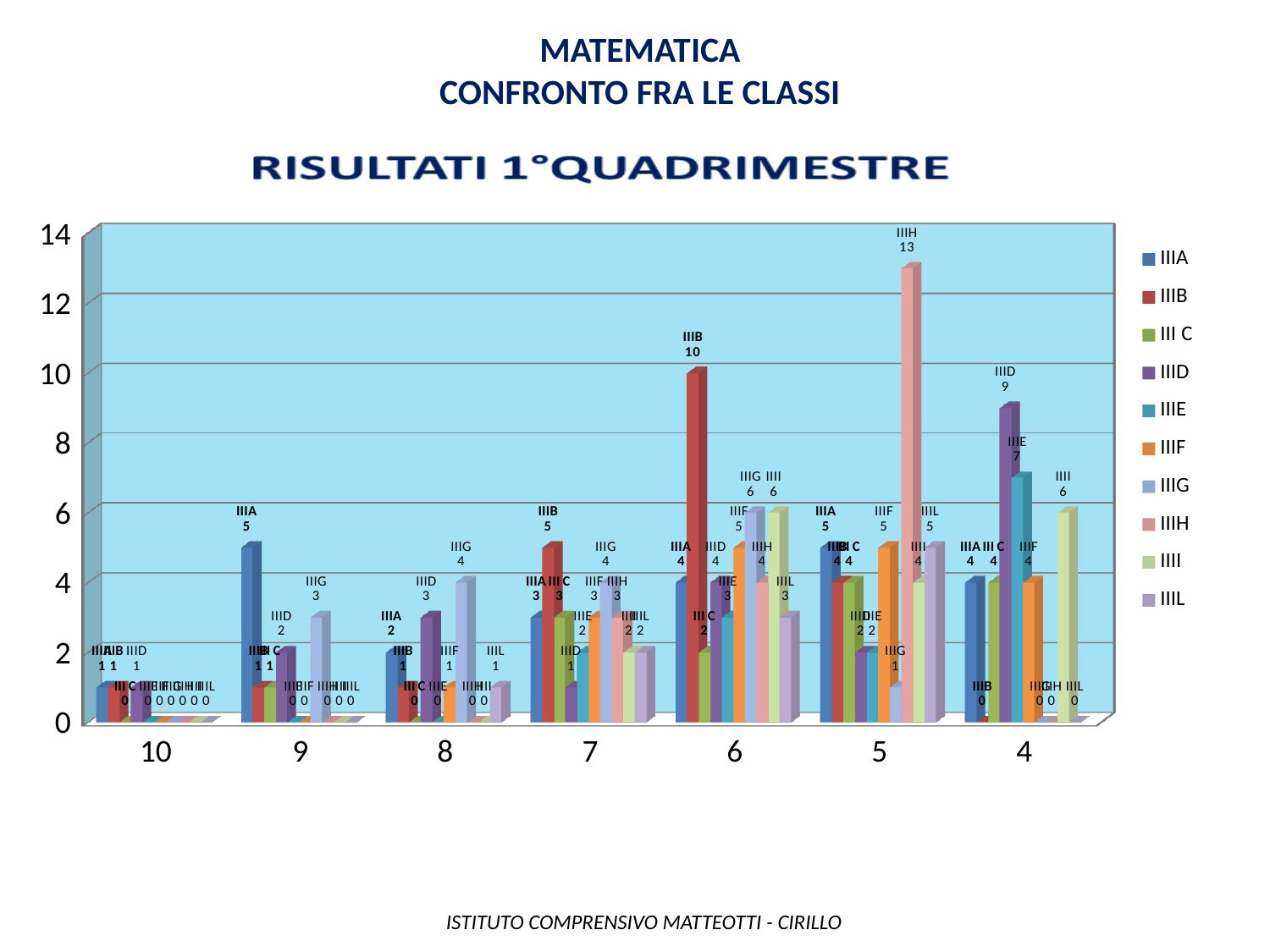
What is the value for class IIID in category 4? 9 What kind of chart is shown on the slide? Bar chart Which class has the highest bar in category 6? IIIB Which class has the highest bar in category 5? IIIH What is the difference between the values for IIIB and IIIA in category 6? 6 In category 4, which is larger: the value for IIID or the value for IIIE? IIID What is the value for class IIIG in category 8? 4 What is the value for class IIIH in category 5? 13 How many series does the legend list? 10 How many categories are shown on the x axis? 7 What is the value for class IIIA in category 9? 5 What is the value for class IIIB in category 6? 10